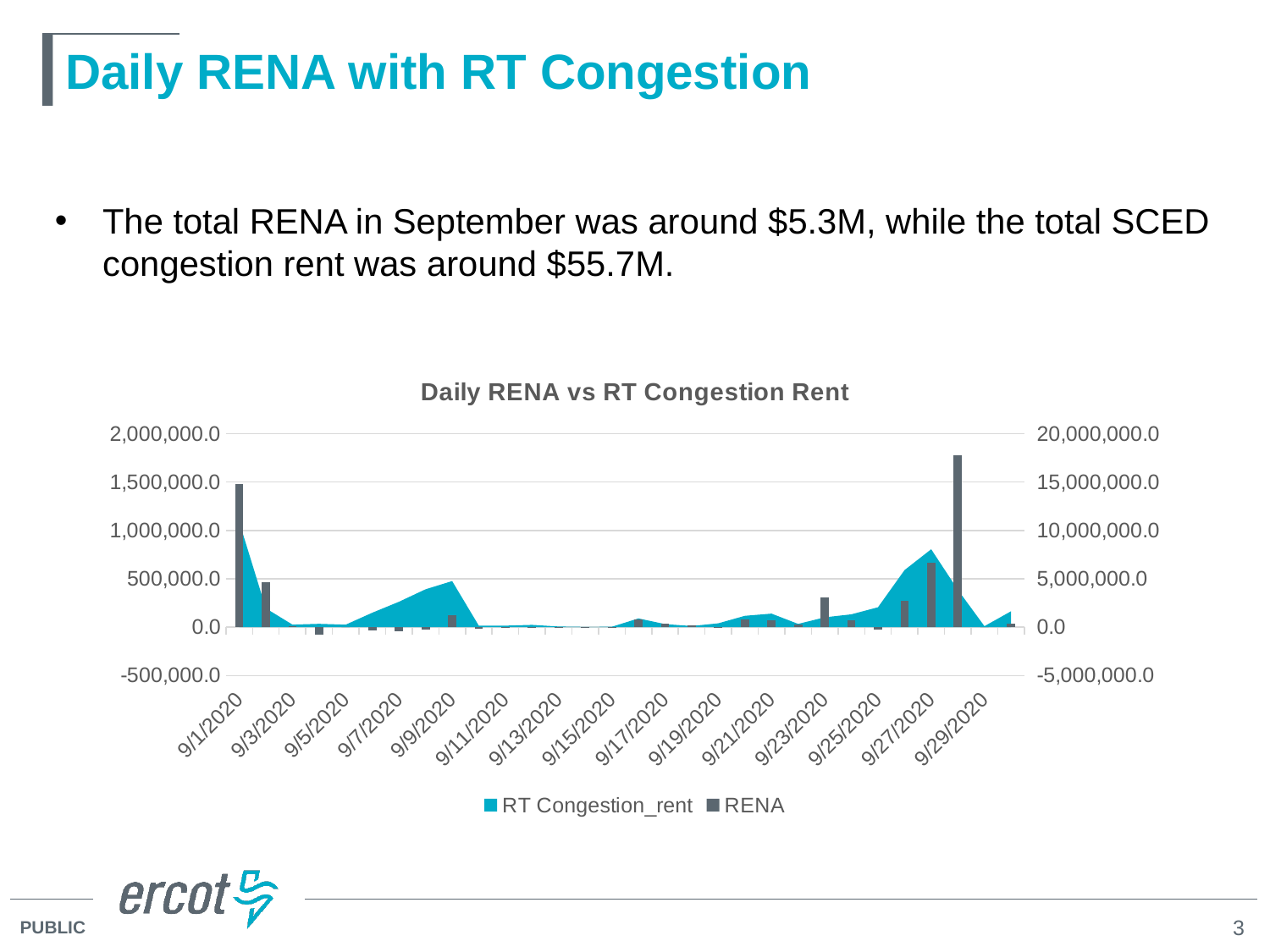
How many series does the chart legend list? 2 What kind of chart is 'Daily RENA vs RT Congestion Rent'? Combination of an area chart and a bar chart Is the RENA value for 9/3/2020 greater or less than 1,000,000.0 on the left axis? less Which date has the larger RENA value, 9/1/2020 or 9/3/2020? 9/1/2020 Does the RT Congestion_rent value rise or fall from 9/1/2020 to 9/3/2020? fall Which date has the larger RENA value, 9/23/2020 or 9/25/2020? 9/23/2020 Is the RENA value for 9/1/2020 greater or less than 1,000,000.0 on the left axis? greater Which date has the larger RT Congestion_rent value, 9/9/2020 or 9/13/2020? 9/9/2020 Which series is shown as dark gray bars in the chart? RENA How many date labels are shown on the x axis of the chart? 15 What is the title of the chart? Daily RENA vs RT Congestion Rent On which date does RT Congestion_rent reach its highest value? 9/1/2020